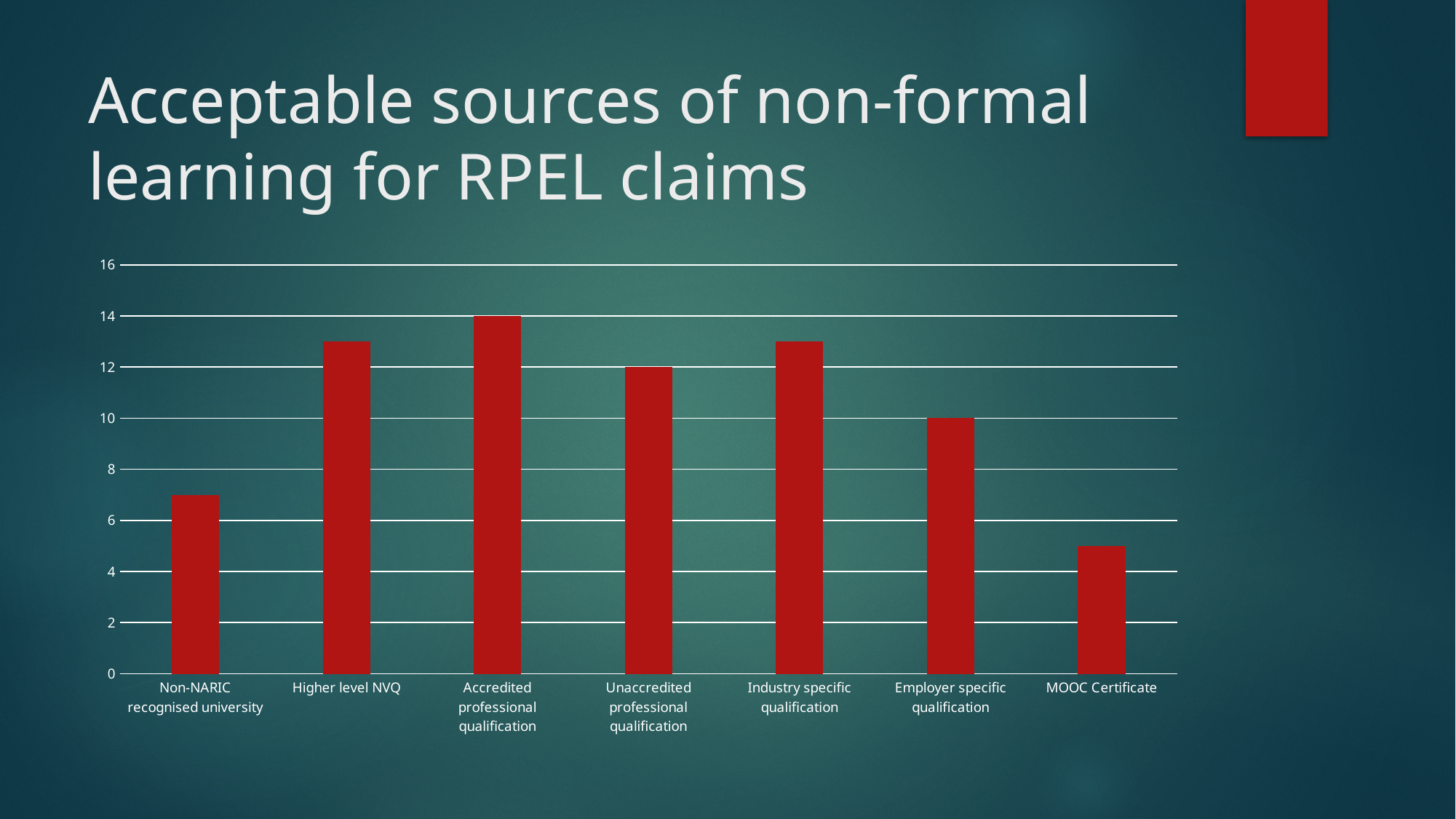
What is the value for Unaccredited professional qualification? 12 What is the difference between the values for Accredited professional qualification and Employer specific qualification? 4 Is the value for MOOC Certificate greater or less than 6? less Which is larger, the value for Non-NARIC recognised university or the value for MOOC Certificate? Non-NARIC recognised university What is the title of the slide containing the chart? Acceptable sources of non-formal learning for RPEL claims Which category has the highest bar? Accredited professional qualification What is the value for Employer specific qualification? 10 What type of chart is shown on the slide? bar chart Which category has the lowest bar? MOOC Certificate What is the value for Accredited professional qualification? 14 Is the value for Higher level NVQ greater or less than 12? greater How many categories are shown on the x axis of the chart? 7